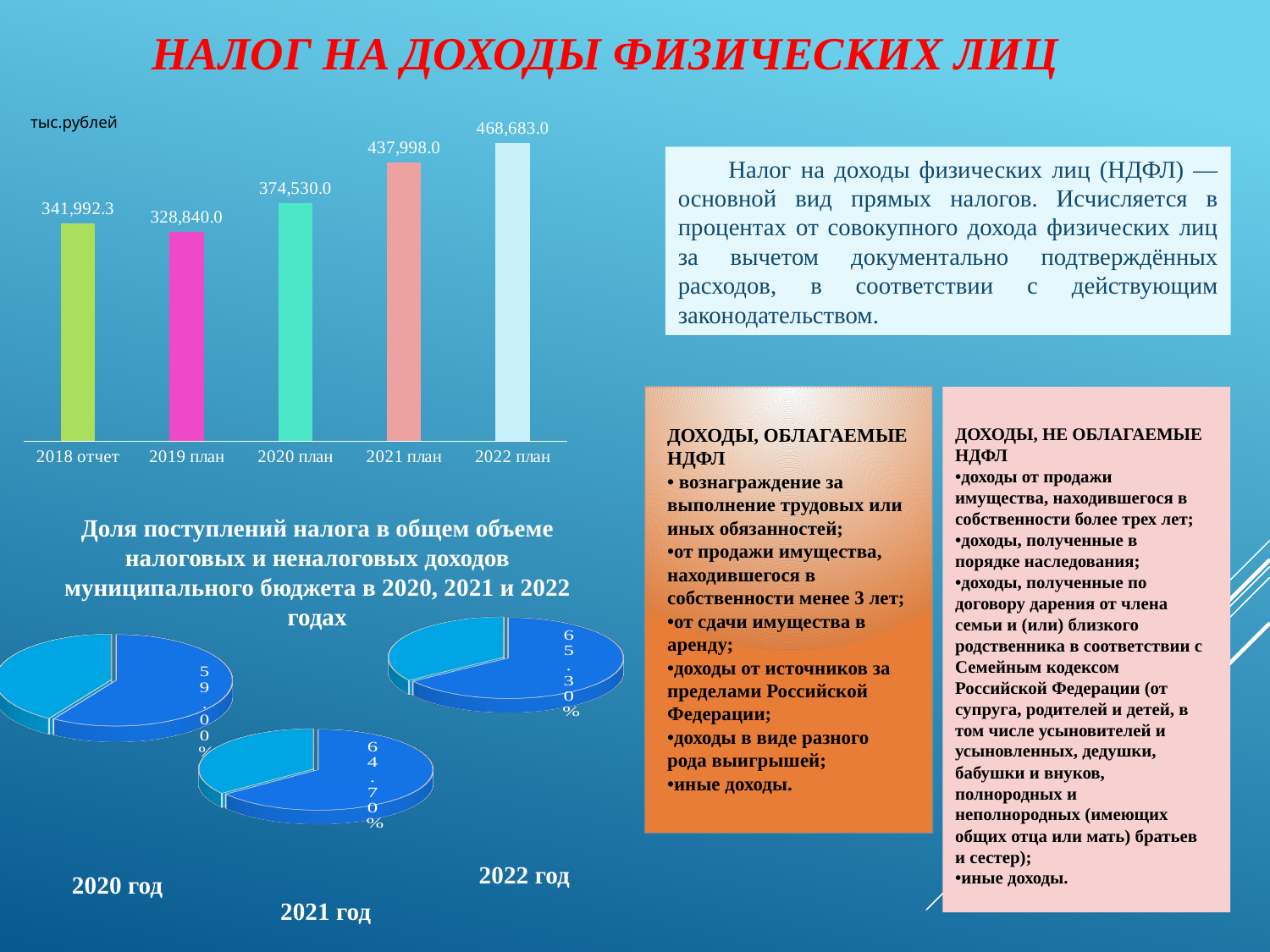
In the bar chart, do the values rise or fall from 2019 план to 2022 план? rise In the bar chart, what is the value for 2020 план? 374,530.0 What unit is indicated for the bar chart values? тыс.рублей In the bar chart, what is the value for 2021 план? 437,998.0 In the bar chart, which category has the highest value? 2022 план What type of chart is used to show the values from 2018 отчет to 2022 план? bar chart In the pie chart for 2021 год, what share is labelled on the highlighted slice? 64.70% In the bar chart, which is larger: the value for 2018 отчет or 2019 план? 2018 отчет How many categories are shown in the bar chart? 5 In the bar chart, what is the difference between the values for 2022 план and 2021 план? 30,685.0 In the bar chart, what is the value for 2018 отчет? 341,992.3 In the bar chart, which category has the lowest value? 2019 план